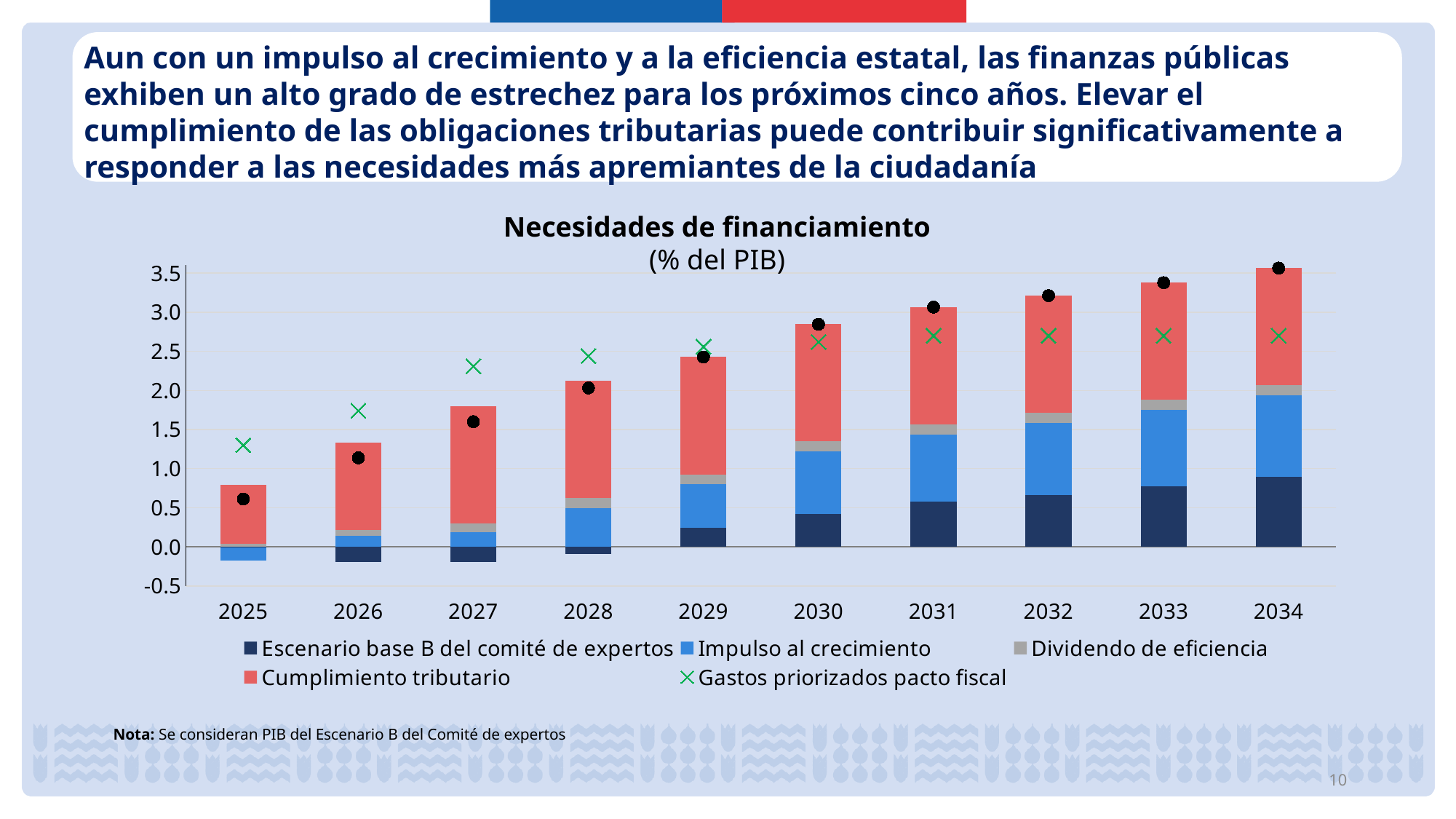
Do the total heights of the stacked bars rise or fall from 2025 to 2034? Rise Is the total height of the stacked bar for 2027 greater or less than 2.0? less In what unit are the values of the chart expressed, according to the subtitle? % del PIB What is the title of the chart? Necesidades de financiamiento How many years are shown on the x axis of the chart? 10 Is the total height of the stacked bar for 2034 greater or less than 3.0? greater Is the total height of the stacked bar for 2025 greater or less than 1.0? less How many series does the chart legend list? 5 Which year has the tallest stacked bar? 2034 Which year has the shortest stacked bar? 2025 What kind of chart is shown on the slide? Stacked bar chart